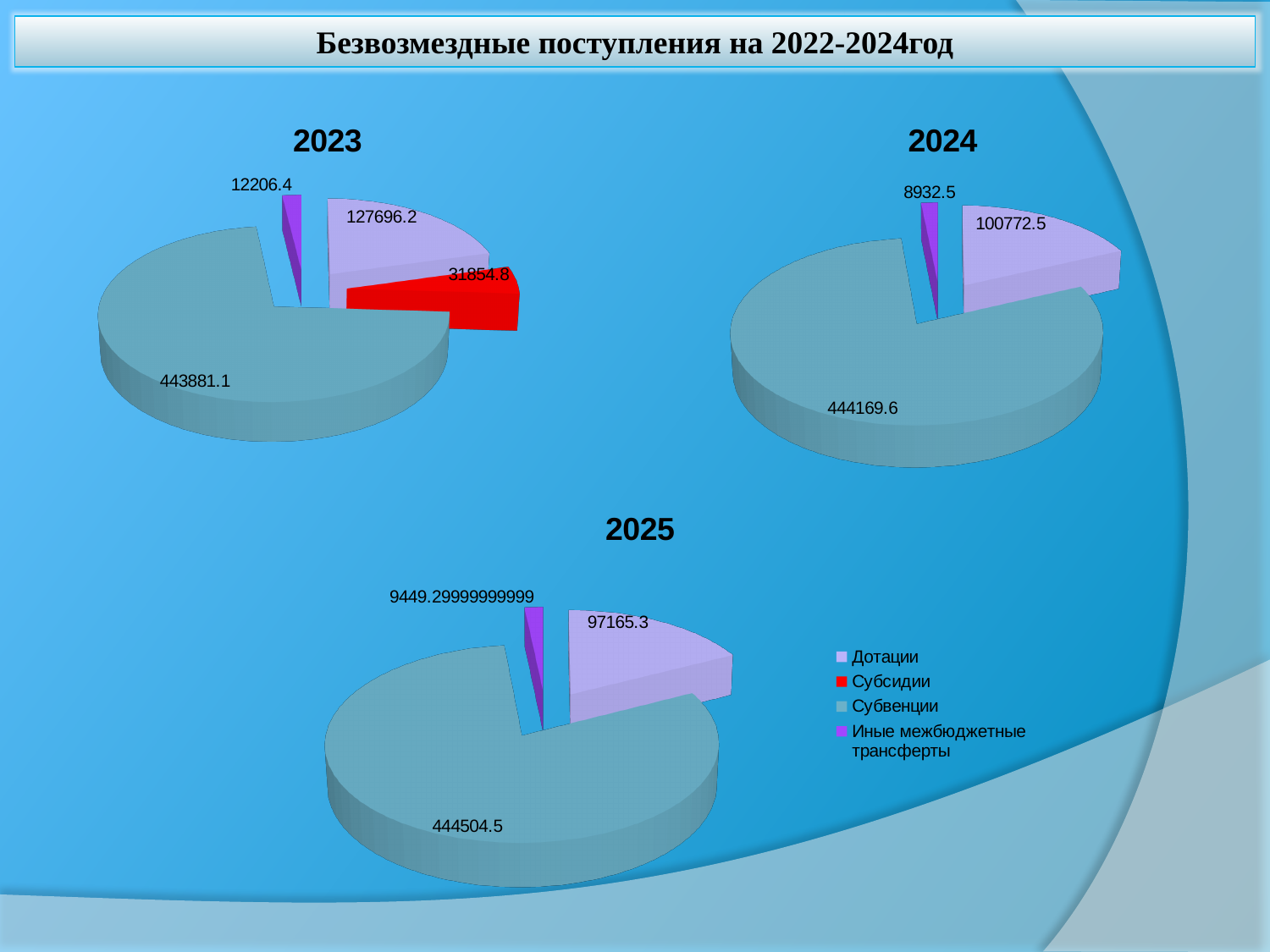
How many slices does the 2023 pie chart have? 4 How many categories does the legend list? 4 In the 2023 pie chart, what is the difference between Дотации and Субсидии? 95841.4 What type of chart is used for 2025? Pie chart In the 2025 pie chart, what is the value for Иные межбюджетные трансферты? 9449.29999999999 In the 2025 pie chart, which is larger, Дотации or Иные межбюджетные трансферты? Дотации In the 2023 pie chart, what is the value for Субсидии? 31854.8 In the 2024 pie chart, what is the value for Дотации? 100772.5 In the 2024 pie chart, what is the difference between Субвенции and Дотации? 343397.1 In the 2023 pie chart, which category has the smallest slice? Иные межбюджетные трансферты In the 2024 pie chart, which category has the largest slice? Субвенции In the 2023 pie chart, what is the value for Субвенции? 443881.1